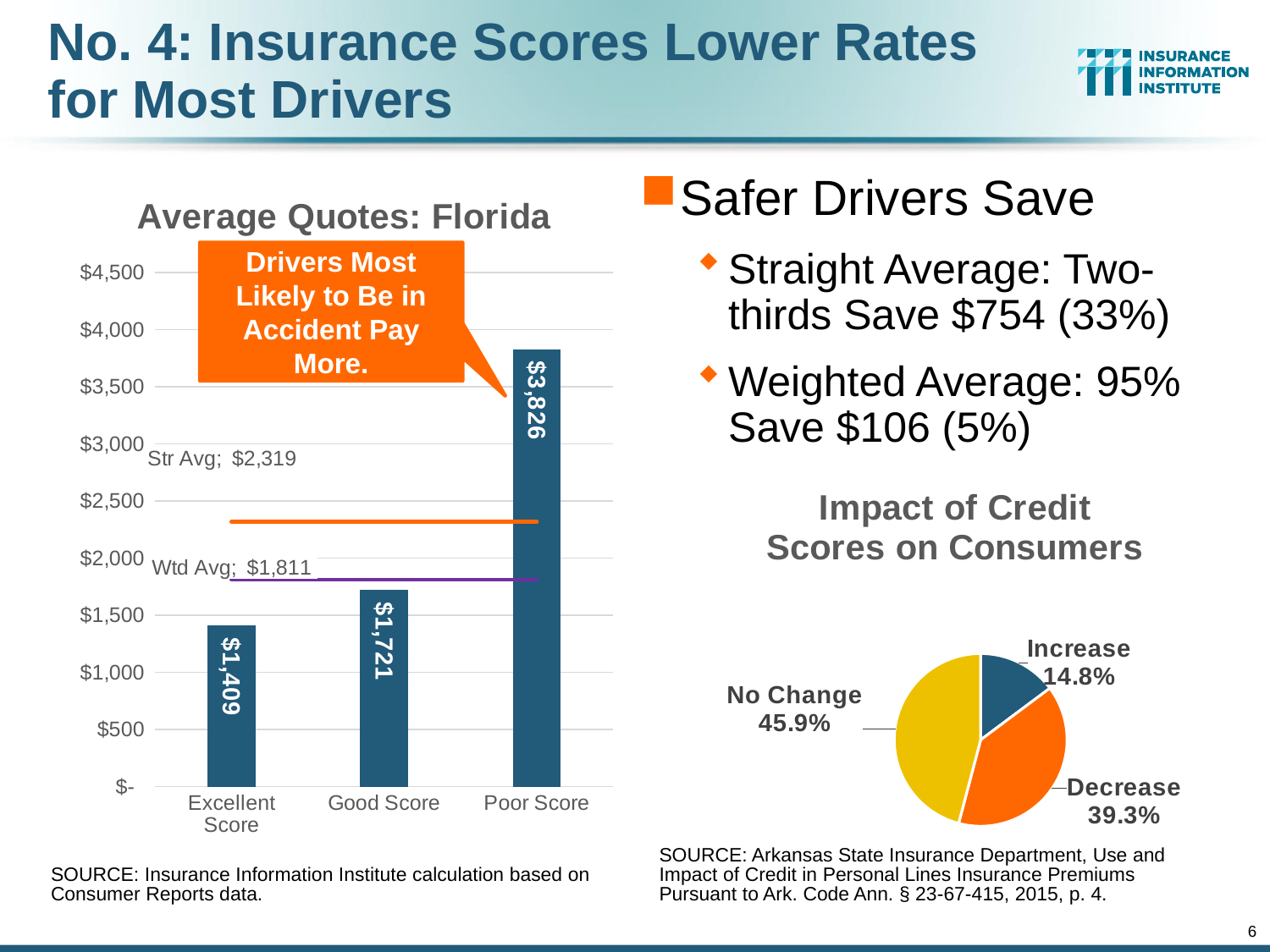
In the 'Average Quotes: Florida' chart, which category has the lowest average quote? Excellent Score In the 'Average Quotes: Florida' chart, which category has the highest average quote? Poor Score In the 'Average Quotes: Florida' chart, what is the average quote for Excellent Score? $1,409 In the 'Average Quotes: Florida' chart, what is the difference between the Poor Score and Excellent Score quotes? $2,417 How many slices does the 'Impact of Credit Scores on Consumers' pie chart have? 3 In the 'Average Quotes: Florida' chart, what value is shown for the Str Avg line? $2,319 In the 'Impact of Credit Scores on Consumers' pie chart, which slice is the largest? No Change In the 'Average Quotes: Florida' chart, what is the average quote for Good Score? $1,721 In the 'Impact of Credit Scores on Consumers' pie chart, what share of consumers saw a Decrease? 39.3% In the 'Average Quotes: Florida' chart, what is the average quote for Poor Score? $3,826 What kind of chart is 'Average Quotes: Florida'? Bar chart In the 'Average Quotes: Florida' chart, what value is shown for the Wtd Avg line? $1,811